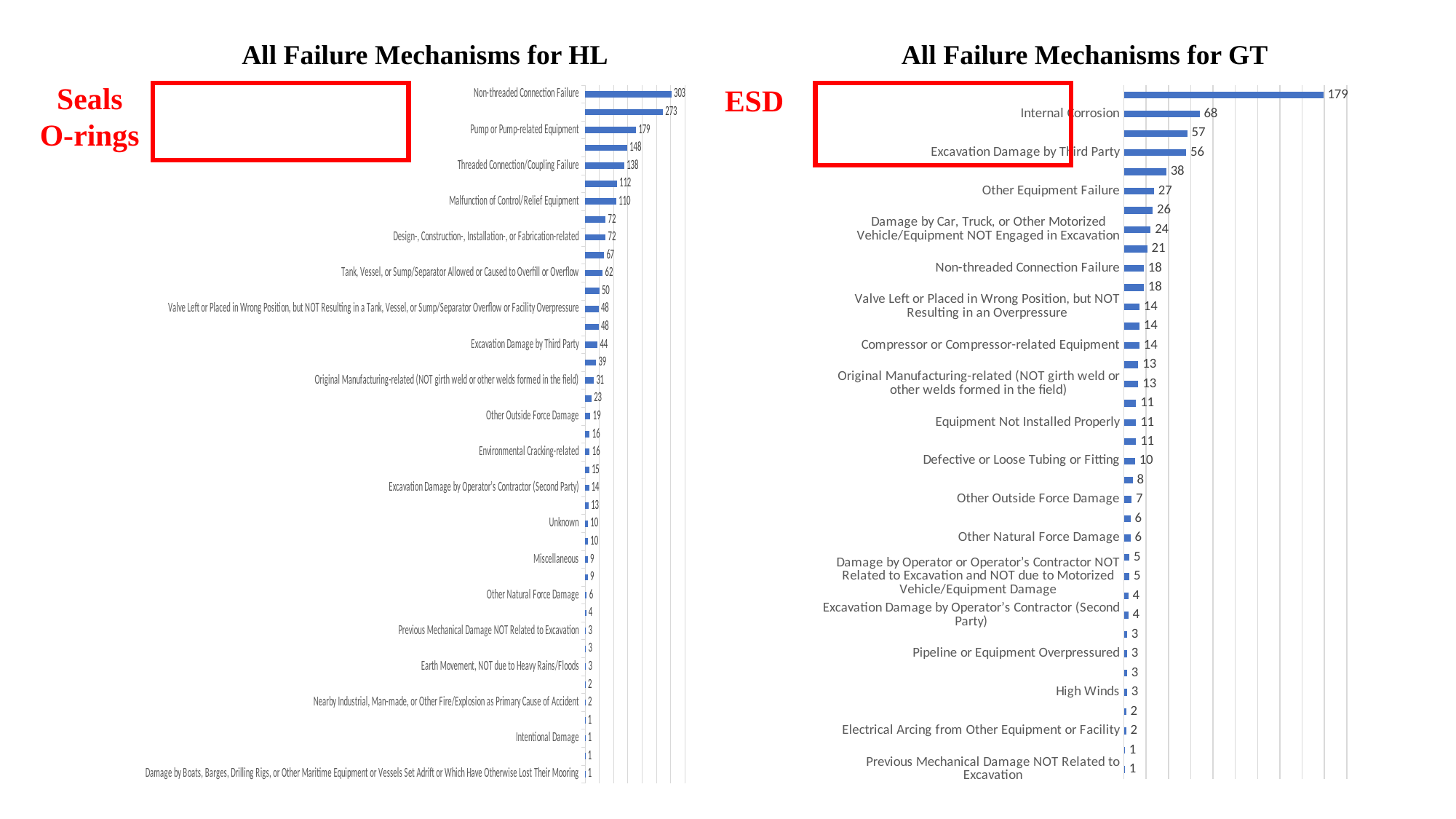
In the 'All Failure Mechanisms for HL' chart, what is the difference between Non-threaded Connection Failure and Pump or Pump-related Equipment? 124 In the 'All Failure Mechanisms for GT' chart, what is the value for Other Equipment Failure? 27 In the 'All Failure Mechanisms for HL' chart, what is the value for Excavation Damage by Third Party? 44 In the 'All Failure Mechanisms for GT' chart, what is the highest value shown? 179 In the 'All Failure Mechanisms for GT' chart, what is the value for Internal Corrosion? 68 In the 'All Failure Mechanisms for GT' chart, what is the value for Excavation Damage by Third Party? 56 In the 'All Failure Mechanisms for GT' chart, what is the difference between Internal Corrosion and Excavation Damage by Third Party? 12 In the 'All Failure Mechanisms for HL' chart, which is larger: Threaded Connection/Coupling Failure or Malfunction of Control/Relief Equipment? Threaded Connection/Coupling Failure In the 'All Failure Mechanisms for HL' chart, what is the value for Pump or Pump-related Equipment? 179 In the 'All Failure Mechanisms for HL' chart, which category has the highest value? Non-threaded Connection Failure What type of chart is 'All Failure Mechanisms for GT'? Bar chart In the 'All Failure Mechanisms for HL' chart, what is the value for Non-threaded Connection Failure? 303